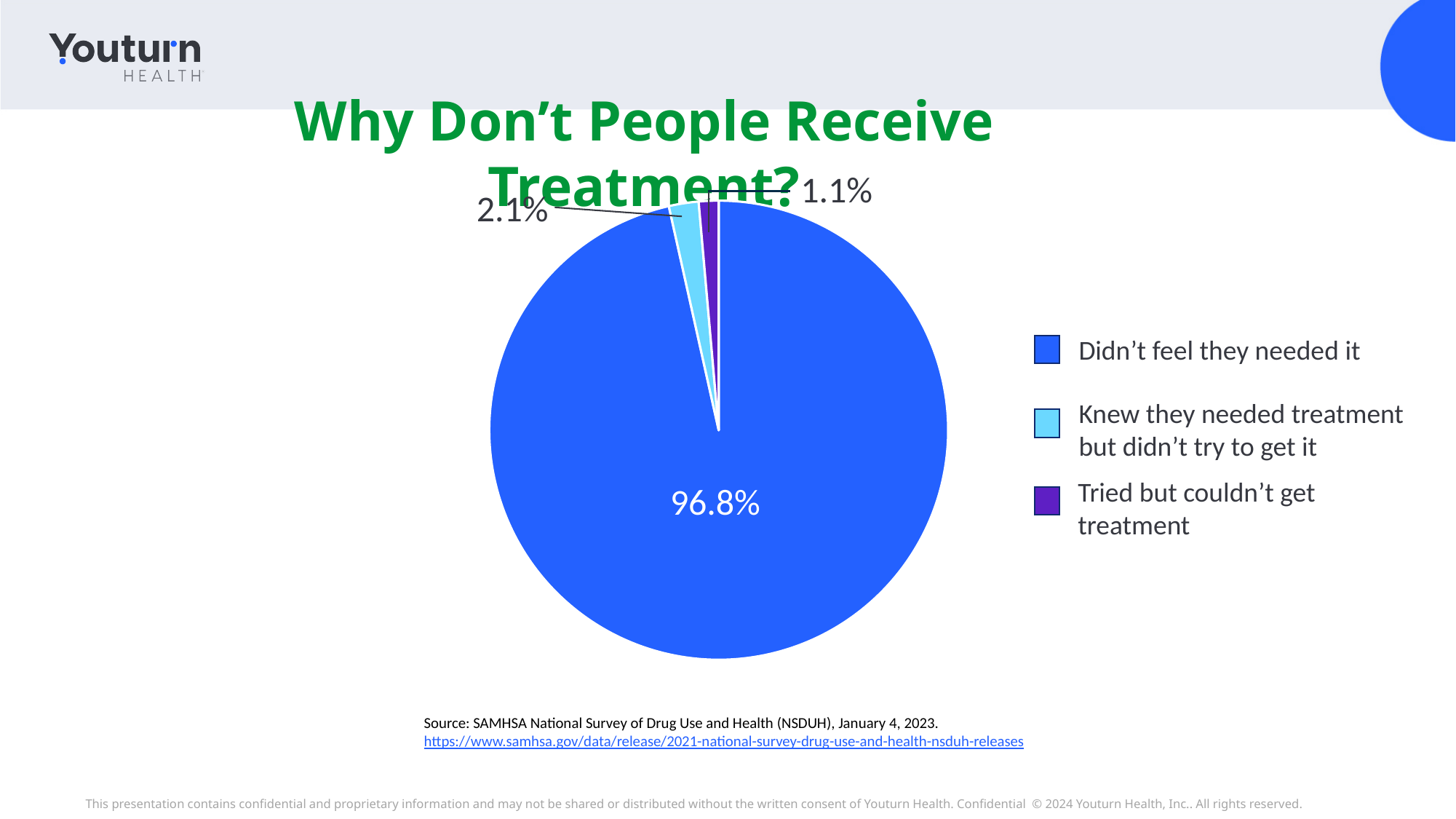
What percentage is shown for "Knew they needed treatment but didn't try to get it"? 2.1% What percentage is shown for "Tried but couldn't get treatment"? 1.1% Which is larger: the slice for "Knew they needed treatment but didn't try to get it" or the slice for "Tried but couldn't get treatment"? Knew they needed treatment but didn't try to get it What kind of chart is shown on the slide? Pie chart What is the title of the chart on the slide? Why Don't People Receive Treatment? How many entries does the legend list? 3 What is the difference in percentage points between "Knew they needed treatment but didn't try to get it" and "Tried but couldn't get treatment"? 1.0 percentage points What percentage of the pie is labelled for "Didn't feel they needed it"? 96.8% What colour is the slice for "Tried but couldn't get treatment"? Purple How many slices does the pie chart have? 3 Which category has the smallest slice of the pie? Tried but couldn't get treatment Which category has the largest slice of the pie? Didn't feel they needed it